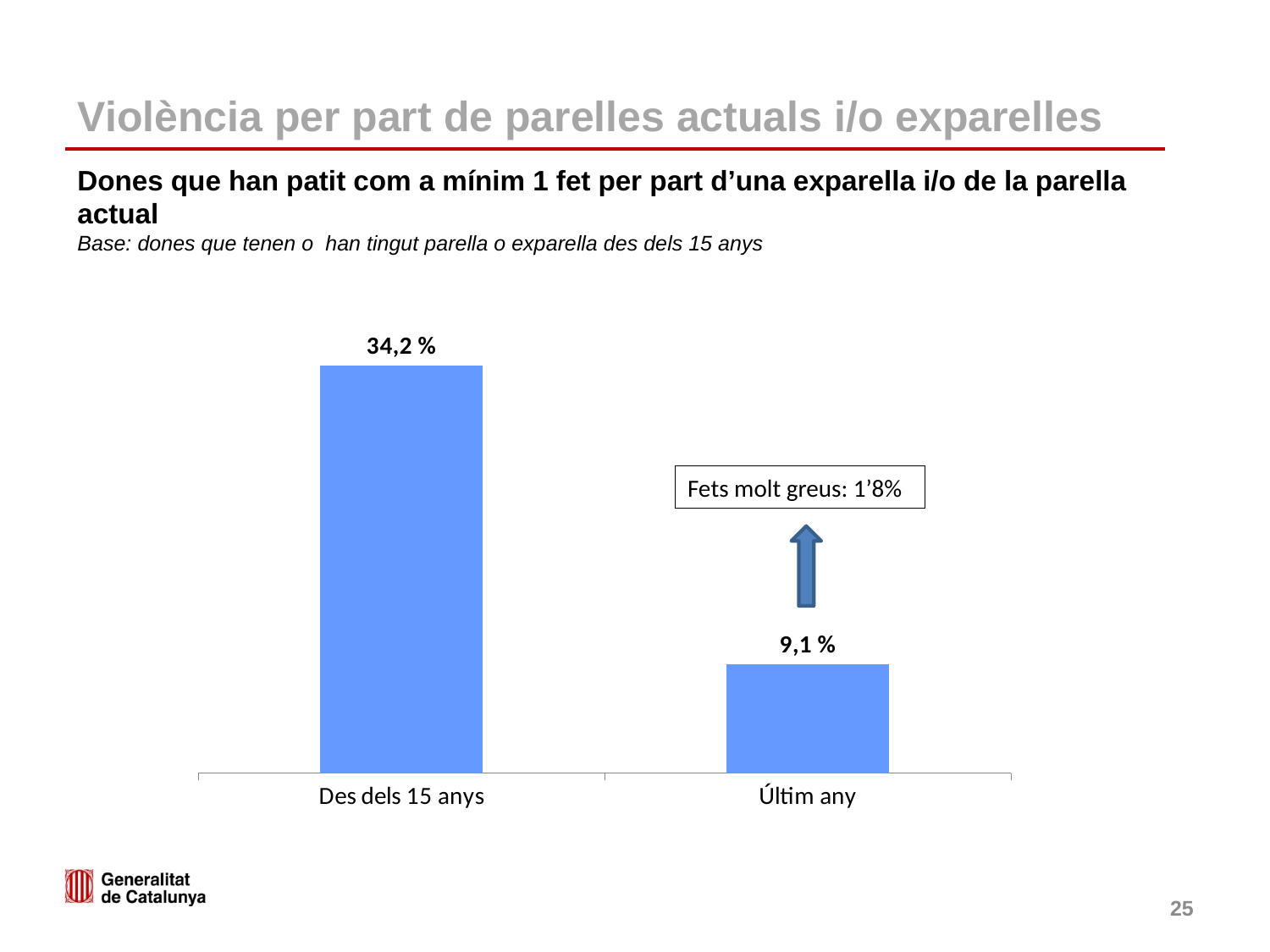
Which is larger, the value for "Des dels 15 anys" or for "Últim any"? Des dels 15 anys How many categories are shown on the chart? 2 What is the difference between the values for "Des dels 15 anys" and "Últim any"? 25,1 % What is the value for "Des dels 15 anys"? 34,2 % Do the values rise or fall from left to right along the x axis? Fall What colour are the bars on the chart? Blue What is the value for "Últim any"? 9,1 % Which category has the lowest value? Últim any What kind of chart is shown on the slide? Bar chart What percentage is given in the callout box for "Fets molt greus"? 1’8% Which category has the highest value? Des dels 15 anys